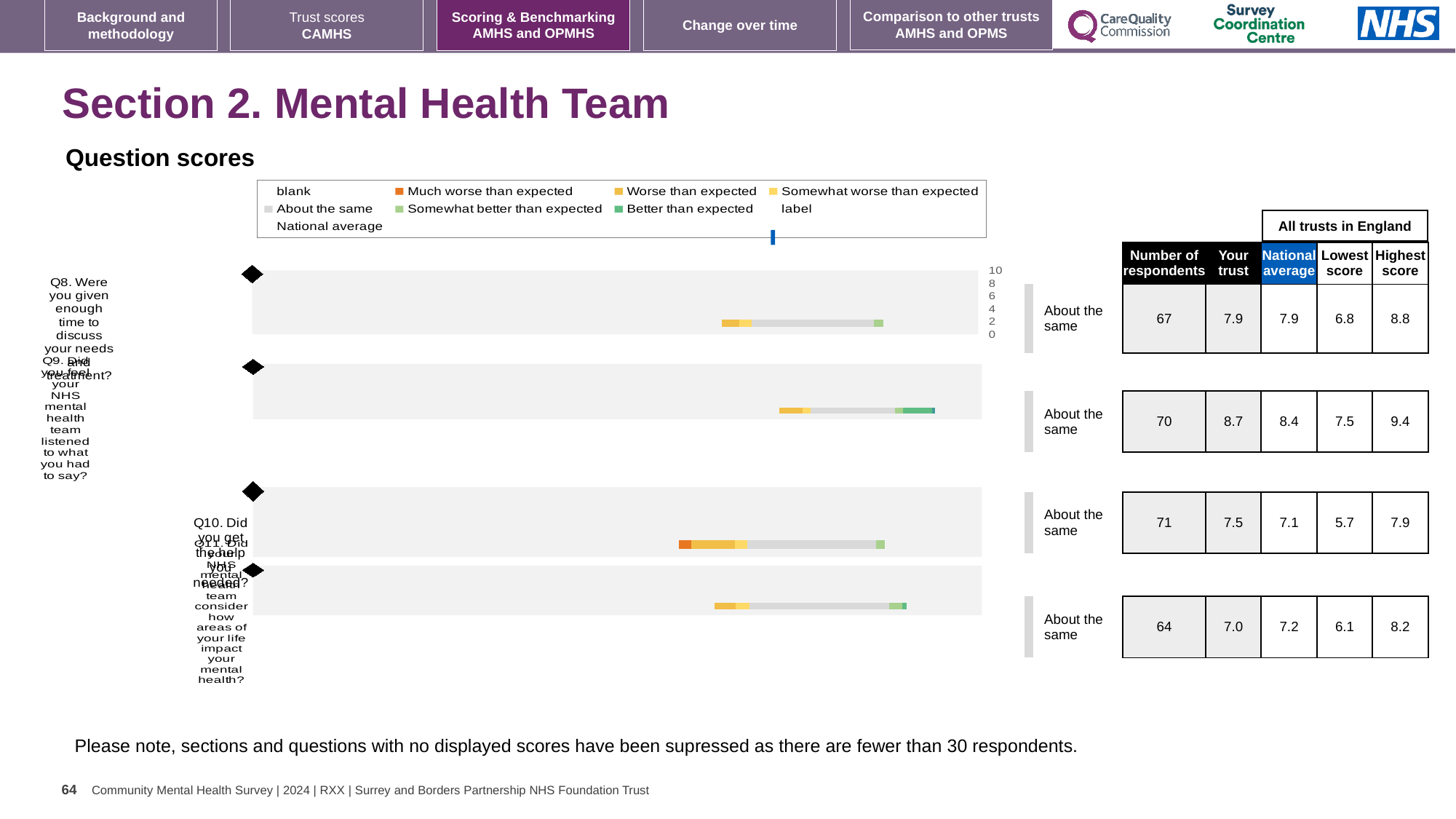
Which question has the lowest 'Your trust' score? Q11 What is the national average score for Q10 (Did you get the help you needed?)? 7.1 What is the highest score among all trusts in England for Q8? 8.8 What is the difference between the 'Your trust' score and the national average for Q9? 0.3 How many questions (categories) are plotted in the question scores chart? 4 Which question has the highest 'Your trust' score? Q9 What kind of chart is used to show the question scores? bar chart For Q11, which is larger: the 'Your trust' score or the national average? National average What is the 'Your trust' score for Q9 (Did you feel your NHS mental health team listened to what you had to say?)? 8.7 What benchmark category is shown for Q8 in the question scores chart? About the same Which legend entry is shown in orange in the question scores chart? Much worse than expected How many respondents answered Q11? 64